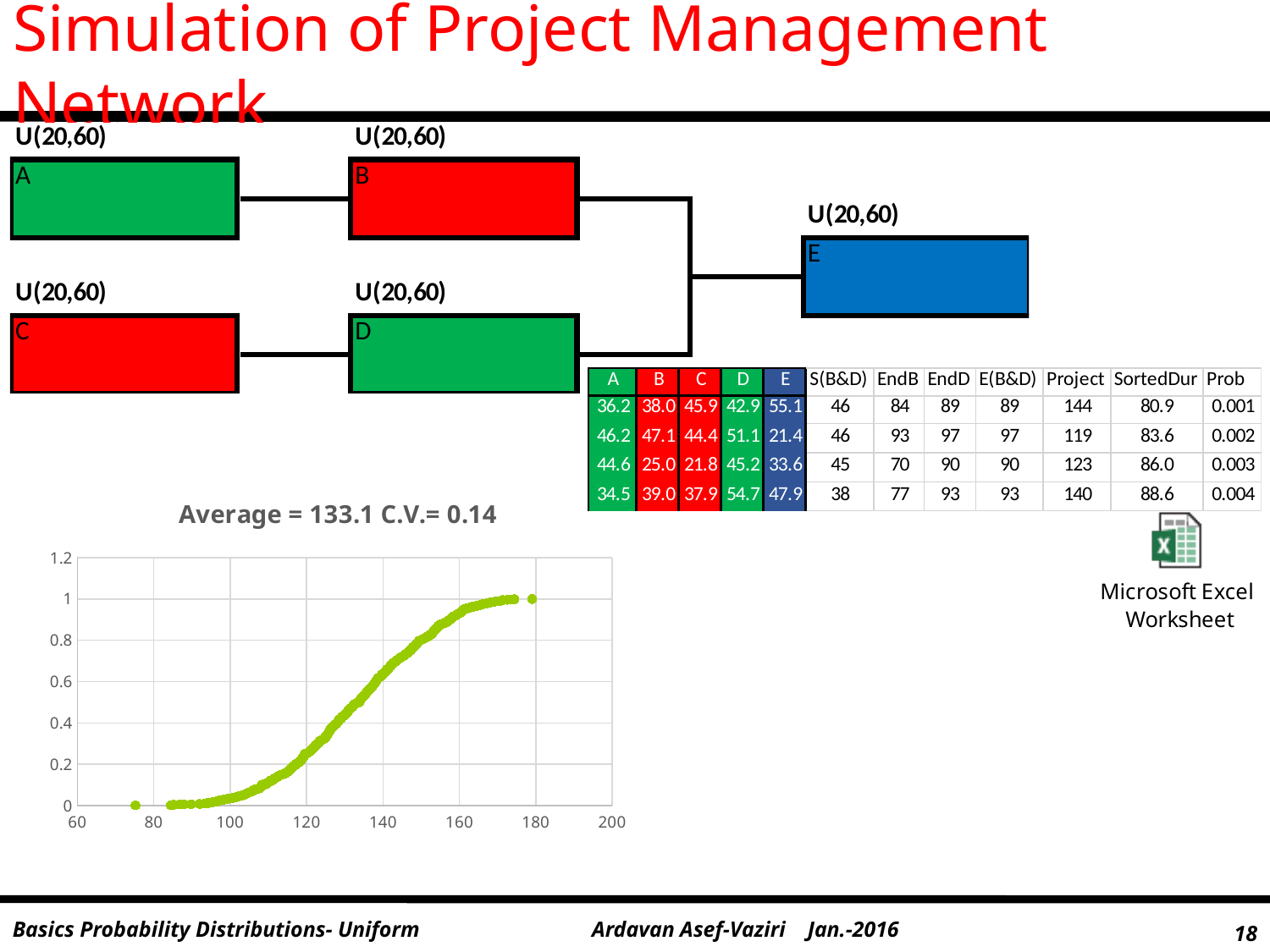
What is the C.V. value stated in the chart title? 0.14 What kind of chart is shown on the slide? scatter chart What is the highest value shown on the chart's y axis? 1.2 What is the title of the chart on the slide? Average = 133.1 C.V.= 0.14 What is the average value stated in the chart title? 133.1 Is the plotted value at x = 100 greater or less than 0.2? less Is the plotted value at x = 180 greater or less than 0.8? greater Is the plotted value at x = 120 greater or less than 0.4? less Do the plotted values rise or fall as the x axis increases from 80 to 180? rise Which is larger, the plotted value at x = 110 or at x = 150? x = 150